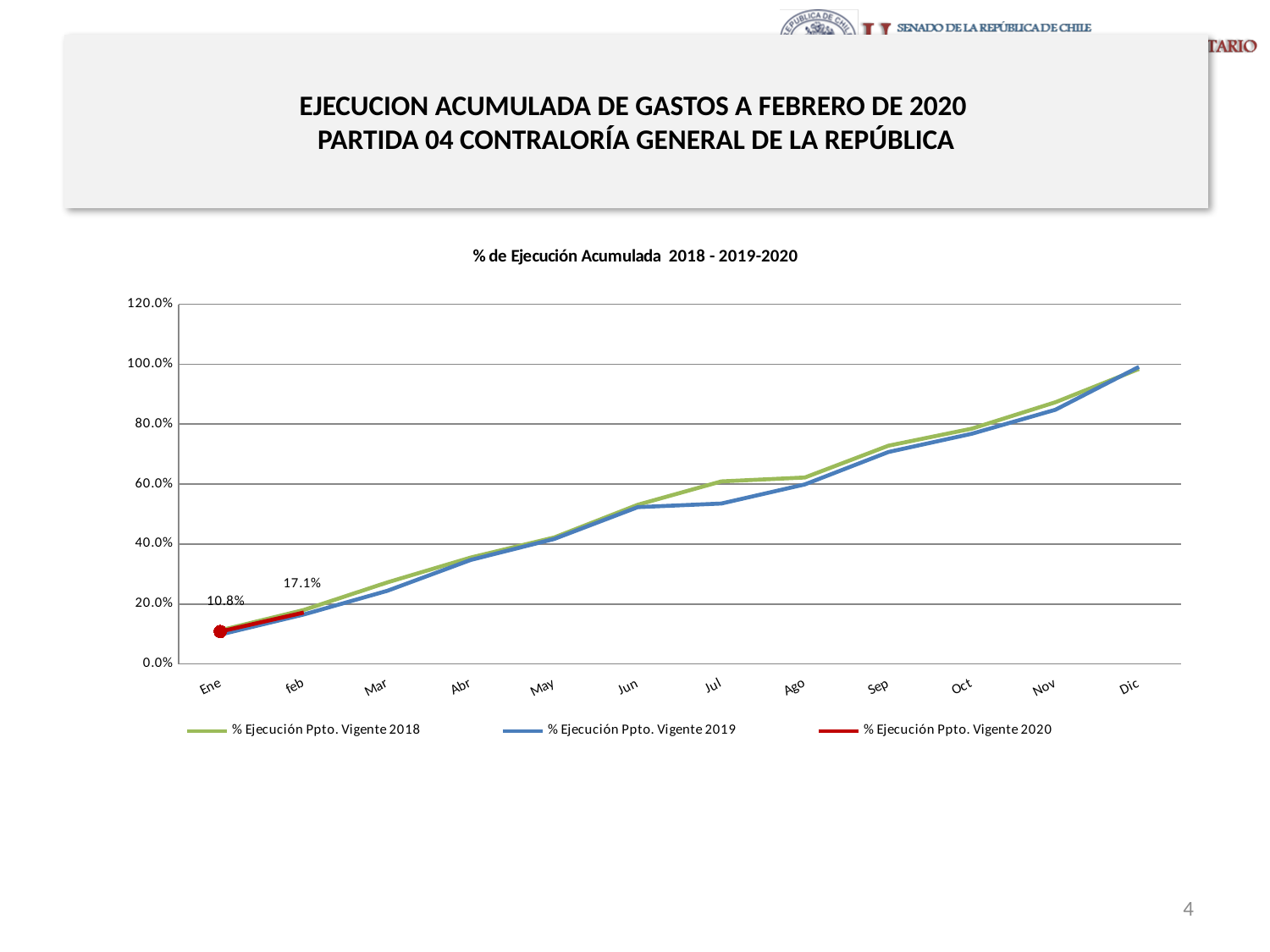
How many months are shown on the x axis? 12 What is the value of % Ejecución Ppto. Vigente 2020 for feb? 17.1% How many series does the legend list? 3 By how many percentage points did % Ejecución Ppto. Vigente 2020 increase from Ene to feb? 6.3 percentage points In Jul, which series has the higher value: % Ejecución Ppto. Vigente 2018 or % Ejecución Ppto. Vigente 2019? % Ejecución Ppto. Vigente 2018 Is the value for % Ejecución Ppto. Vigente 2019 in Mar greater or less than 40.0%? less What is the title of the chart? % de Ejecución Acumulada 2018 - 2019-2020 Do the values for % Ejecución Ppto. Vigente 2018 rise or fall from Ene to Dic? Rise Is the value for % Ejecución Ppto. Vigente 2019 in Dic greater or less than 80.0%? greater What is the value of % Ejecución Ppto. Vigente 2020 for Ene? 10.8% In which month does % Ejecución Ppto. Vigente 2018 reach its highest value? Dic What kind of chart is shown on the slide? Line chart